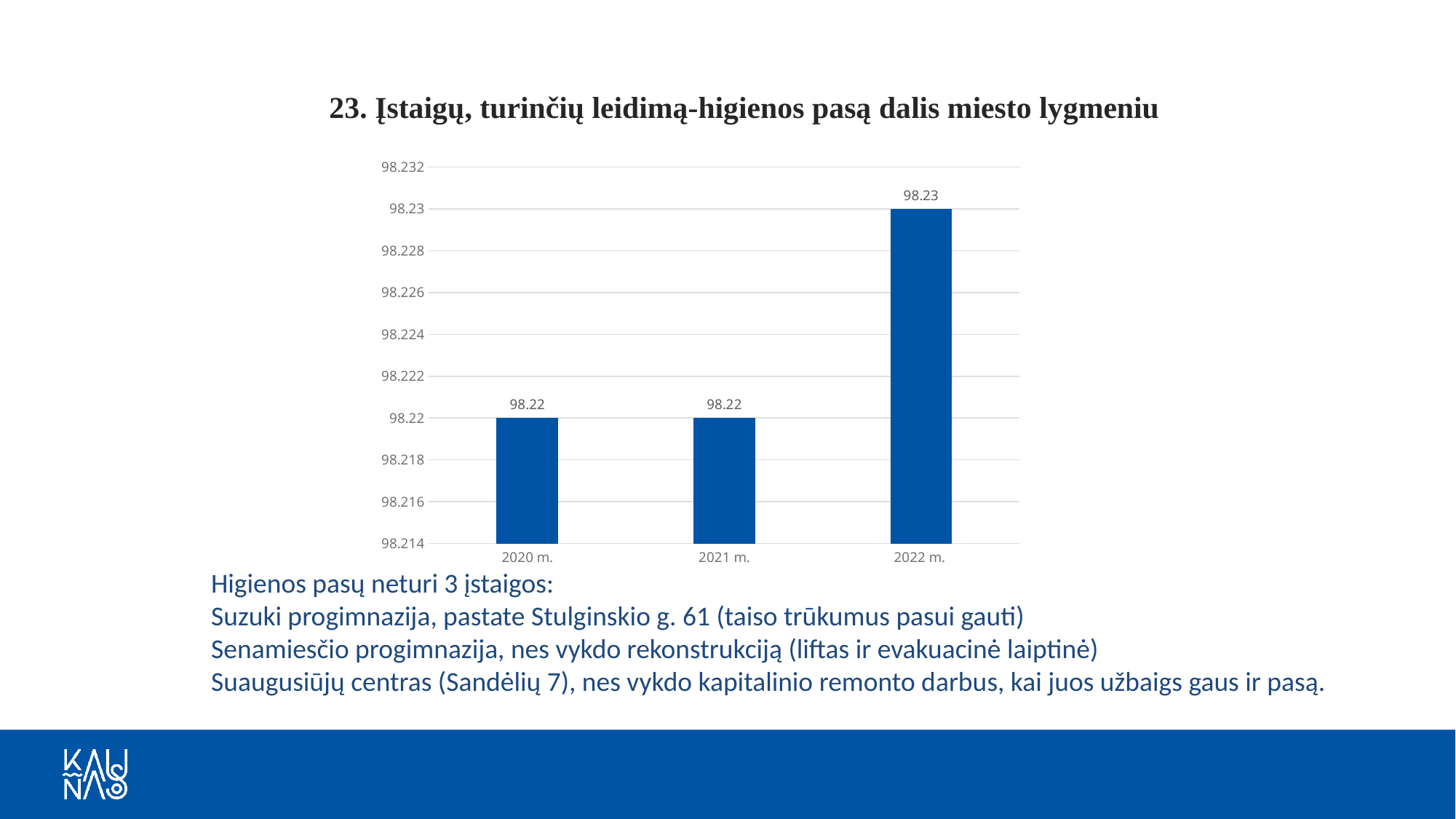
How many years are shown on the x axis? 3 What kind of chart is shown on the slide? bar chart What is the difference between the values for 2022 m. and 2020 m.? 0.01 Is the value for 2022 m. greater or less than 98.228? greater Which year has the highest value? 2022 m. Which is larger, the value for 2022 m. or the value for 2021 m.? 2022 m. Do the values rise or fall from 2020 m. to 2022 m.? rise What is the value for 2020 m.? 98.22 What is the value for 2022 m.? 98.23 Is the value for 2020 m. greater or less than 98.224? less What is the value for 2021 m.? 98.22 What is the title of the chart? 23. Įstaigų, turinčių leidimą-higienos pasą dalis miesto lygmeniu